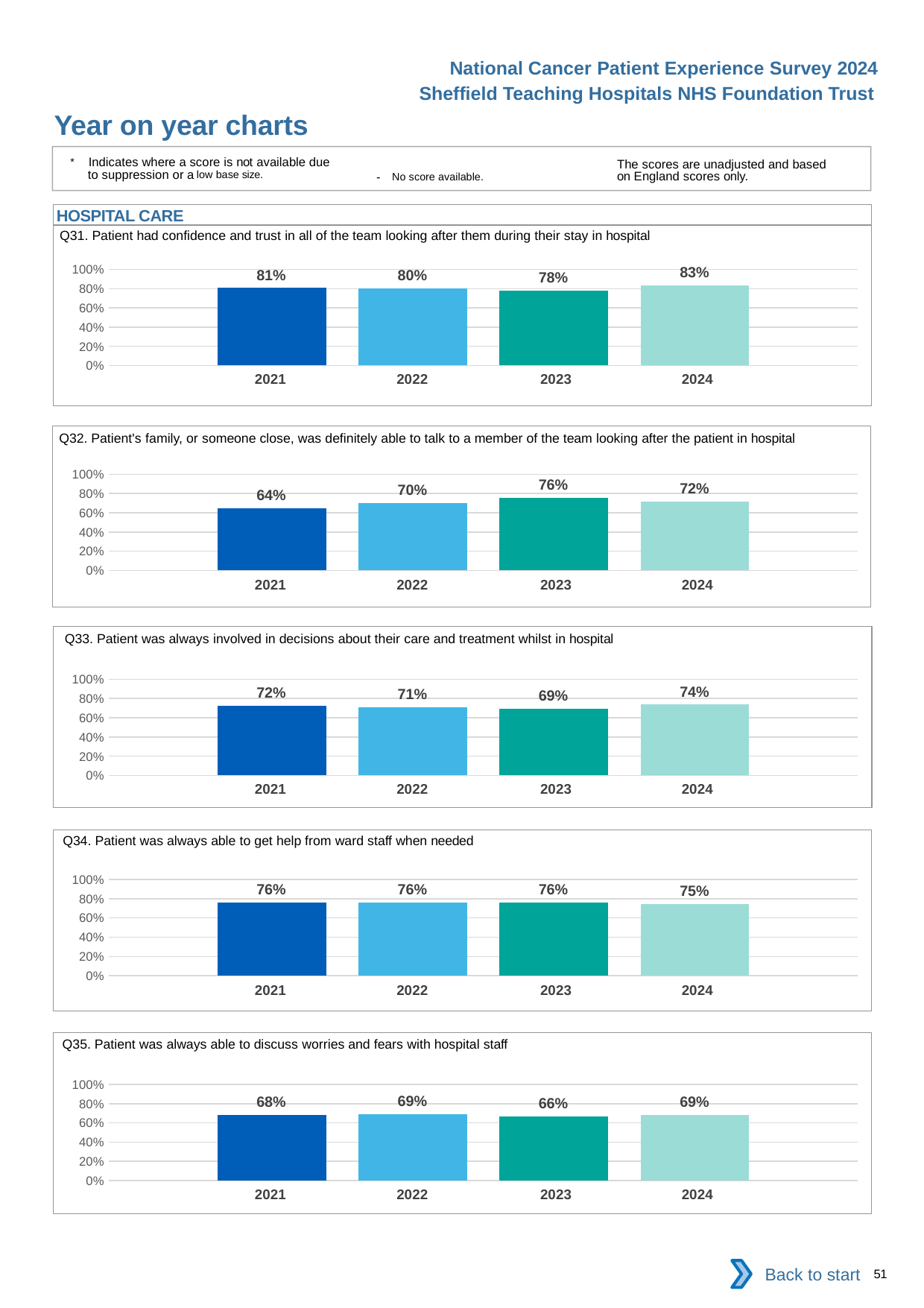
In the Q33 chart (patient was always involved in decisions about their care), which is larger, the value for 2021 or the value for 2022? 2021 In the Q35 chart (patient was always able to discuss worries and fears), what is the value for 2023? 66% In the Q32 chart (patient's family was definitely able to talk to a member of the team), what is the value for 2021? 64% In the Q31 chart (patient had confidence and trust in all of the team), what is the value for 2024? 83% In the Q31 chart (patient had confidence and trust in all of the team), which year has the lowest value? 2023 In the Q32 chart (patient's family was definitely able to talk to a member of the team), which year has the highest value? 2023 In the Q33 chart (patient was always involved in decisions about their care), what is the value for 2023? 69% In the Q34 chart (patient was always able to get help from ward staff), what is the value for 2024? 75% What kind of chart is the Q31 chart (patient had confidence and trust in all of the team)? Bar chart In the Q34 chart (patient was always able to get help from ward staff), how many years are shown on the x axis? 4 In the Q35 chart (patient was always able to discuss worries and fears), is the value for 2021 greater or less than 60%? greater In the Q32 chart (patient's family was definitely able to talk to a member of the team), what is the difference between the 2023 and 2021 values? 12%